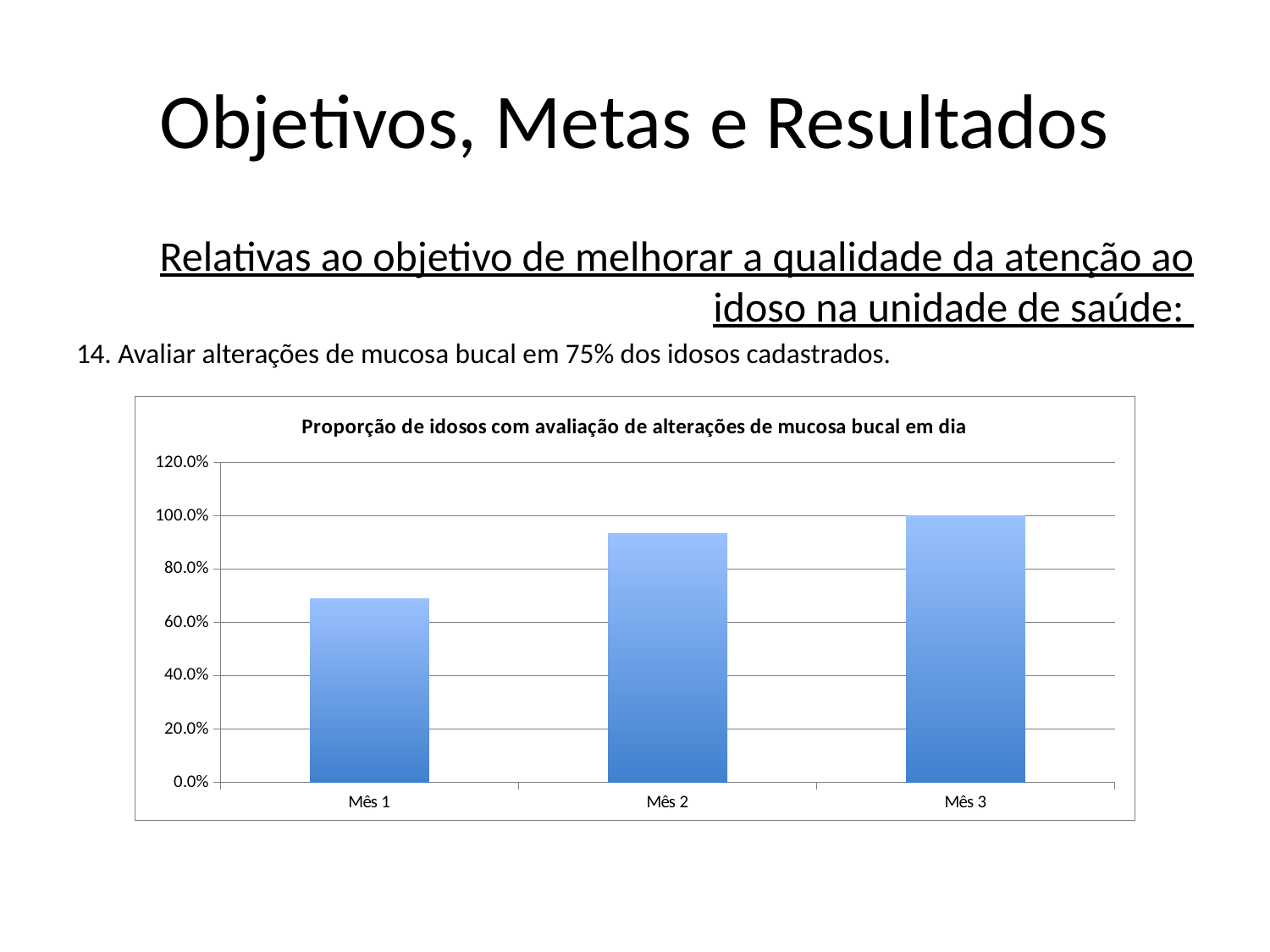
Which is larger, the value for Mês 1 or the value for Mês 2? Mês 2 Is the value for Mês 1 greater or less than 80.0%? less What kind of chart is shown on the slide? bar chart How many categories are plotted on the x axis of the chart? 3 Is the value for Mês 1 greater or less than 60.0%? greater Which month has the highest value in the chart? Mês 3 What is the value for Mês 3 in the chart? 100.0% Do the values rise or fall from Mês 1 to Mês 3? rise Is the value for Mês 2 greater or less than 100.0%? less What is the title of the chart? Proporção de idosos com avaliação de alterações de mucosa bucal em dia Which month has the lowest value in the chart? Mês 1